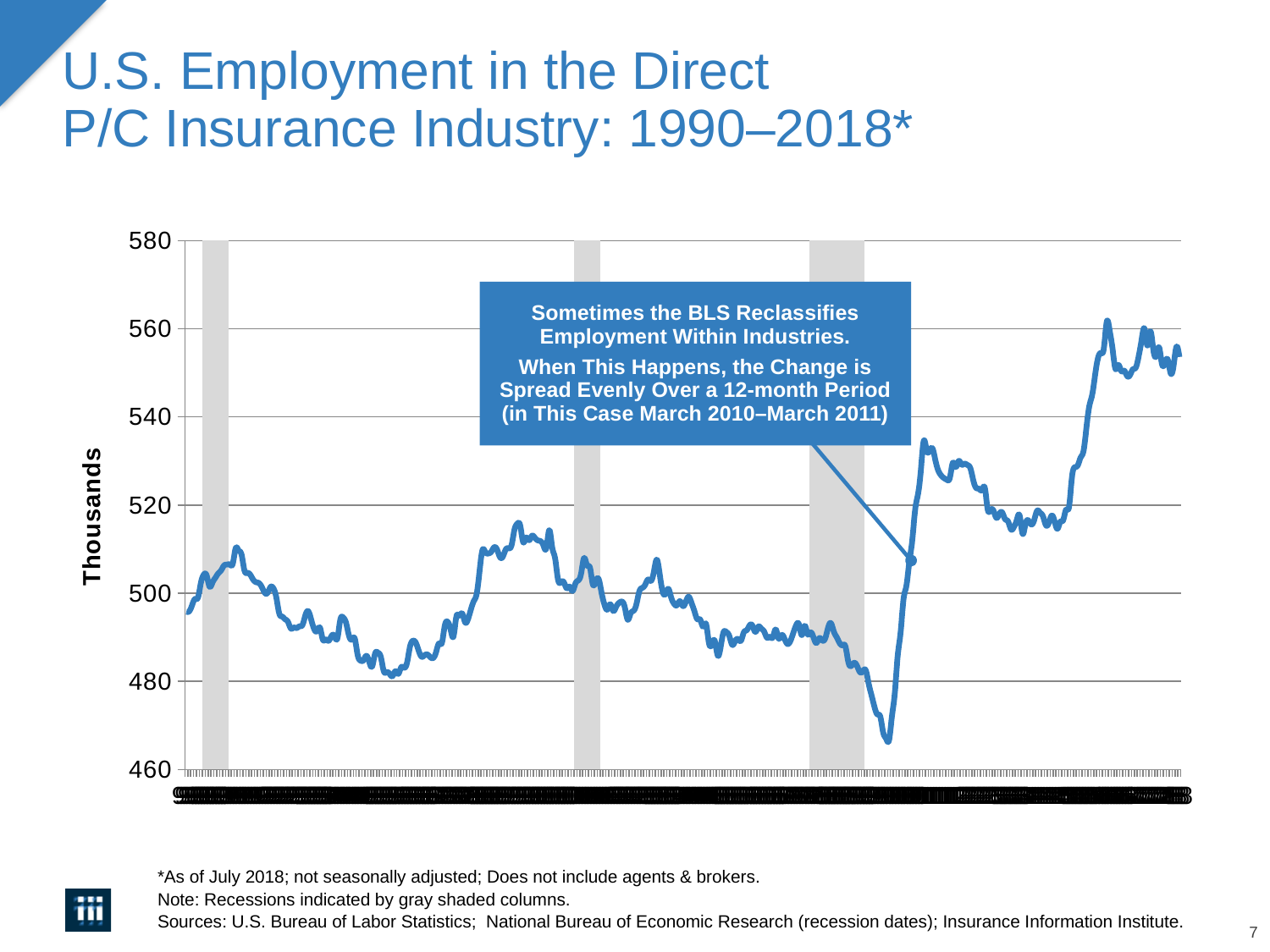
Is the value at the right-hand end of the line (2018) greater or less than 540? greater How many lines (data series) are plotted on the chart? 1 Is the value at the end of the chart (2018) higher or lower than the value at the start (1990)? higher What is the highest value shown on the y-axis of the chart? 580 Does the line ever rise above 580 on the chart? No What is the title of the y-axis on the chart? Thousands Is the highest point of the line on the chart greater or less than 540? greater How many gray shaded recession columns appear on the chart? 3 According to the note on the slide, what do the gray shaded columns on the chart indicate? Recessions What type of chart is shown on the slide? line chart